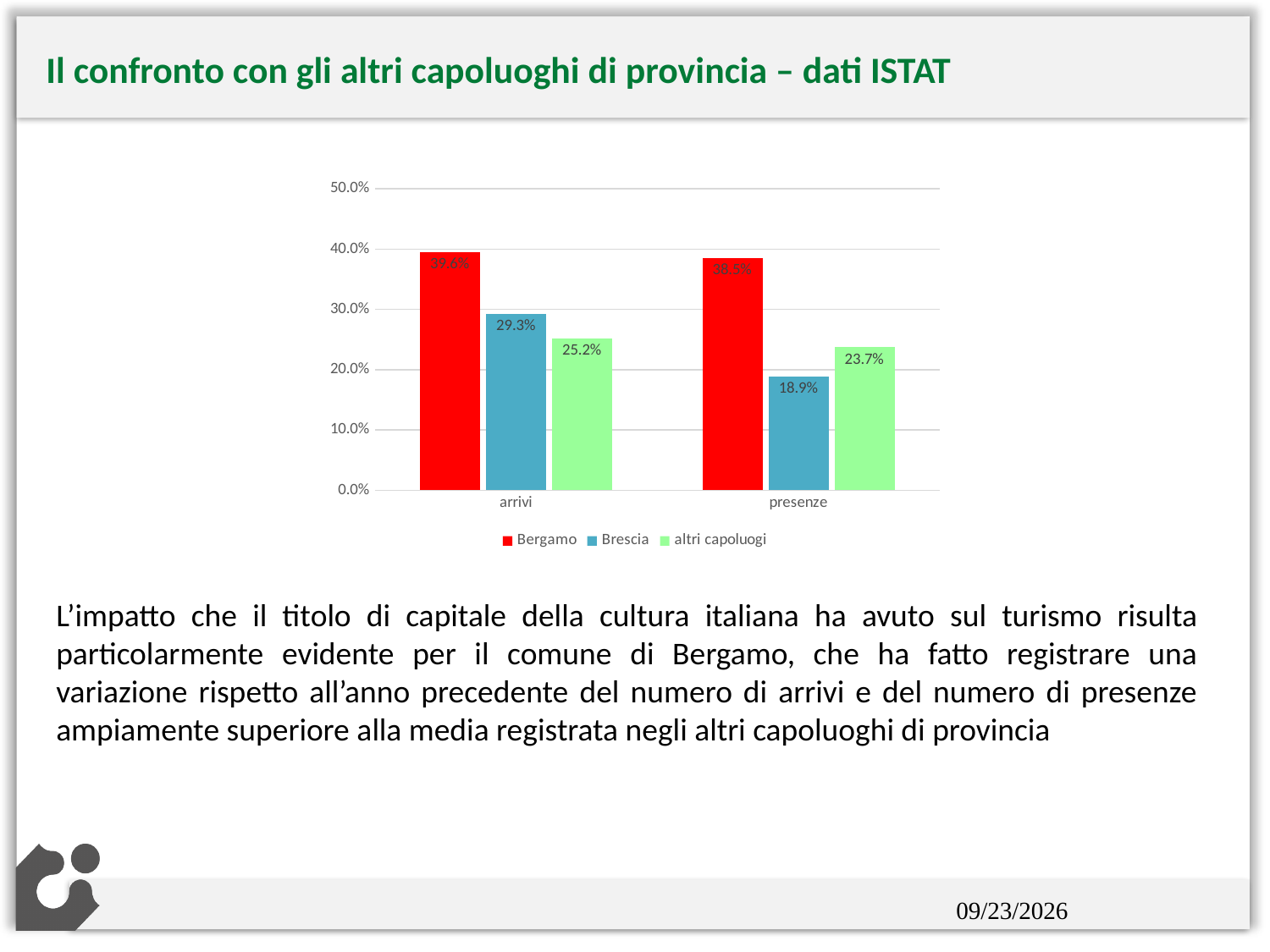
Is the value for Brescia in presenze greater or less than 20.0%? less What is the value for Brescia in the presenze category? 18.9% Which series has the highest value in the presenze category? Bergamo Which is larger: Brescia in arrivi or altri capoluogi in presenze? Brescia in arrivi What is the value for Bergamo in the presenze category? 38.5% How many categories are shown on the x axis? 2 How many series does the legend list? 3 Which series has the lowest value in the arrivi category? altri capoluogi What is the value for Bergamo in the arrivi category? 39.6% What is the difference between Bergamo and Brescia in the arrivi category? 10.3% What kind of chart is shown on the slide? bar chart What is the value for altri capoluogi in the arrivi category? 25.2%